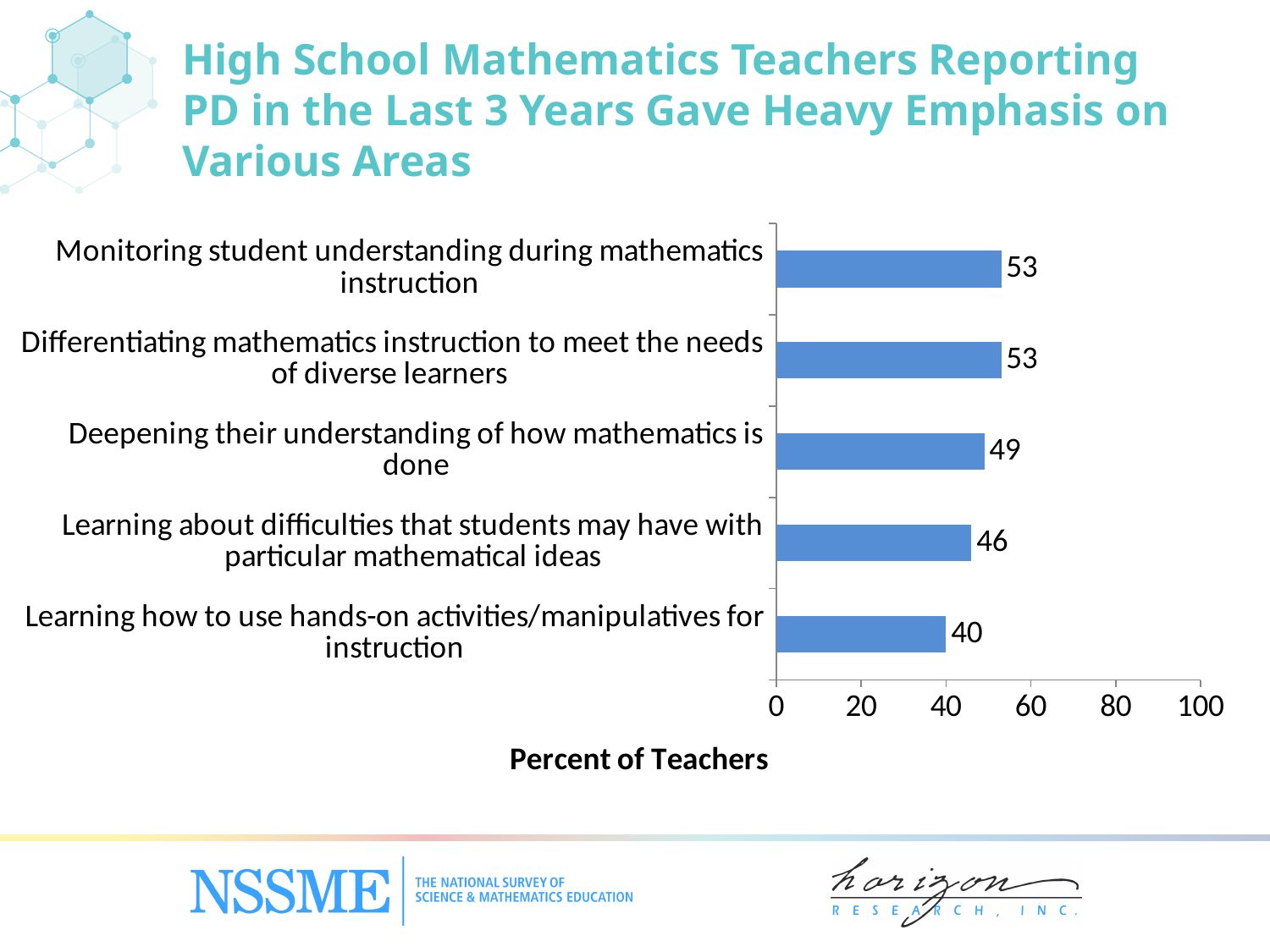
What is the label of the horizontal axis? Percent of Teachers What percent of teachers reported heavy emphasis on learning how to use hands-on activities/manipulatives for instruction? 40 Is the value for differentiating mathematics instruction to meet the needs of diverse learners greater or less than 60? less What kind of chart is shown on the slide? Bar chart How many areas are shown in the chart? 5 What percent of teachers reported heavy emphasis on monitoring student understanding during mathematics instruction? 53 What is the difference in percent of teachers between deepening their understanding of how mathematics is done and learning how to use hands-on activities/manipulatives for instruction? 9 What percent of teachers reported heavy emphasis on deepening their understanding of how mathematics is done? 49 Which area has the lowest percent of teachers reporting heavy emphasis? Learning how to use hands-on activities/manipulatives for instruction What percent of teachers reported heavy emphasis on learning about difficulties that students may have with particular mathematical ideas? 46 Which is larger: the percent for deepening their understanding of how mathematics is done or the percent for learning about difficulties that students may have with particular mathematical ideas? Deepening their understanding of how mathematics is done What is the difference in percent of teachers between monitoring student understanding during mathematics instruction and learning about difficulties that students may have with particular mathematical ideas? 7